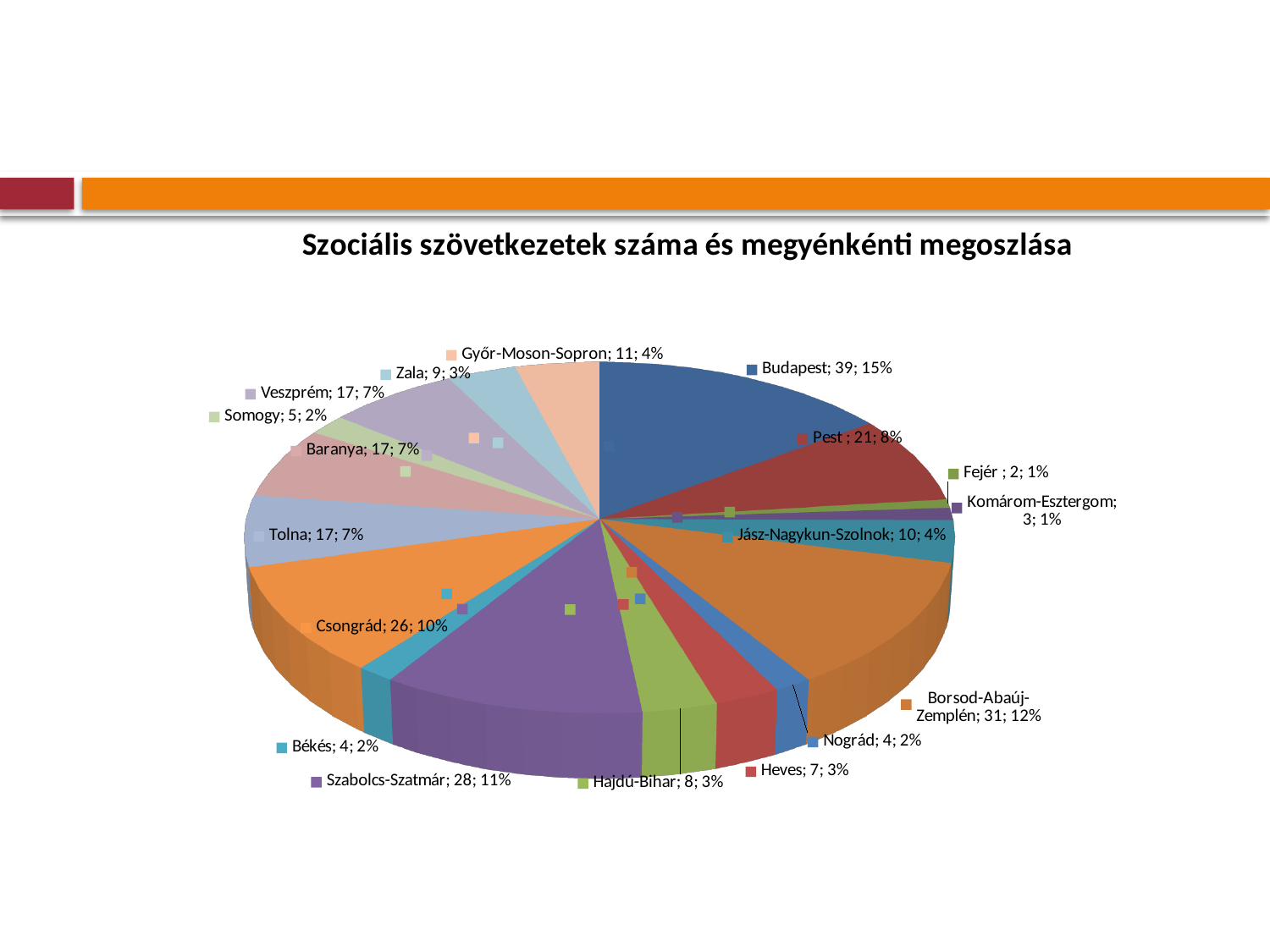
What is the value shown for Budapest? 39 What is the title of the chart? Szociális szövetkezetek száma és megyénkénti megoszlása What is the value shown for Komárom-Esztergom? 3 What is the difference between the values for Budapest and Pest? 18 What kind of chart is shown on the slide? Pie chart What is the value shown for Csongrád? 26 What percentage share does Tolna have? 7% What percentage share does Borsod-Abaúj-Zemplén have? 12% Which is larger, the value for Szabolcs-Szatmár or the value for Csongrád? Szabolcs-Szatmár How many counties (slices) are shown in the pie chart? 18 Which county has the smallest slice of the pie? Fejér Which county has the largest slice of the pie? Budapest